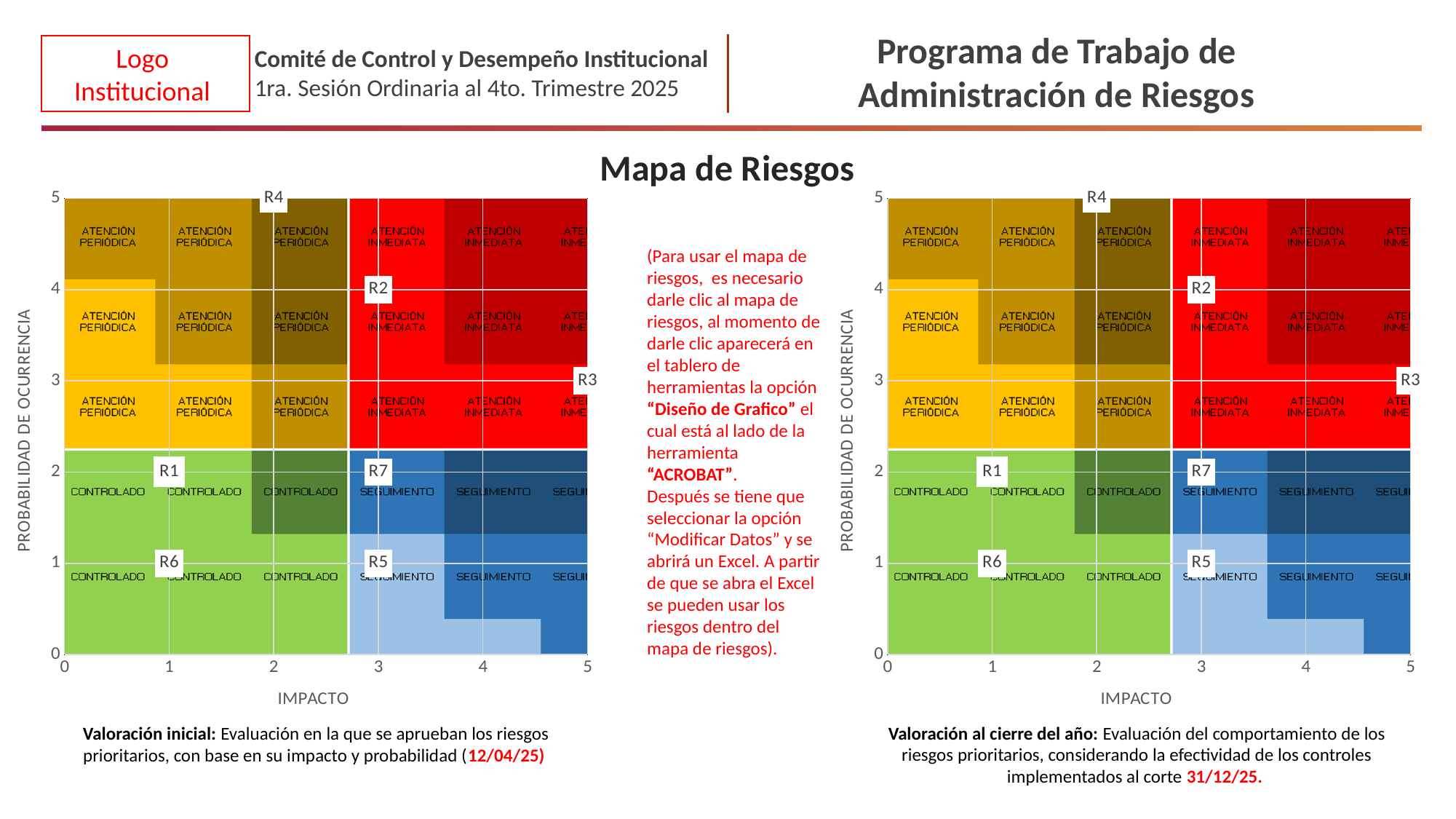
What is the maximum value shown on the IMPACTO axis of the left chart? 5 In the right chart (Valoración al cierre del año), how many risk points (R labels) are plotted? 7 In the right chart (Valoración al cierre del año), is the impact for R6 greater or less than 2? less In the left chart (Valoración inicial), which risk has the highest probability of occurrence? R4 In the left chart (Valoración inicial), which risk has the highest impact? R3 What is the title shown above the two charts? Mapa de Riesgos In the left chart (Valoración inicial), which has the higher probability of occurrence, R4 or R6? R4 In the left chart (Valoración inicial), how many risk points (R labels) are plotted? 7 In the left chart (Valoración inicial), what is the label of the horizontal axis? IMPACTO In the left chart (Valoración inicial), is the probability of occurrence for R4 greater or less than 4? greater In the right chart (Valoración al cierre del año), is the impact for R3 greater or less than 4? greater In the right chart (Valoración al cierre del año), which has the higher impact, R7 or R1? R7